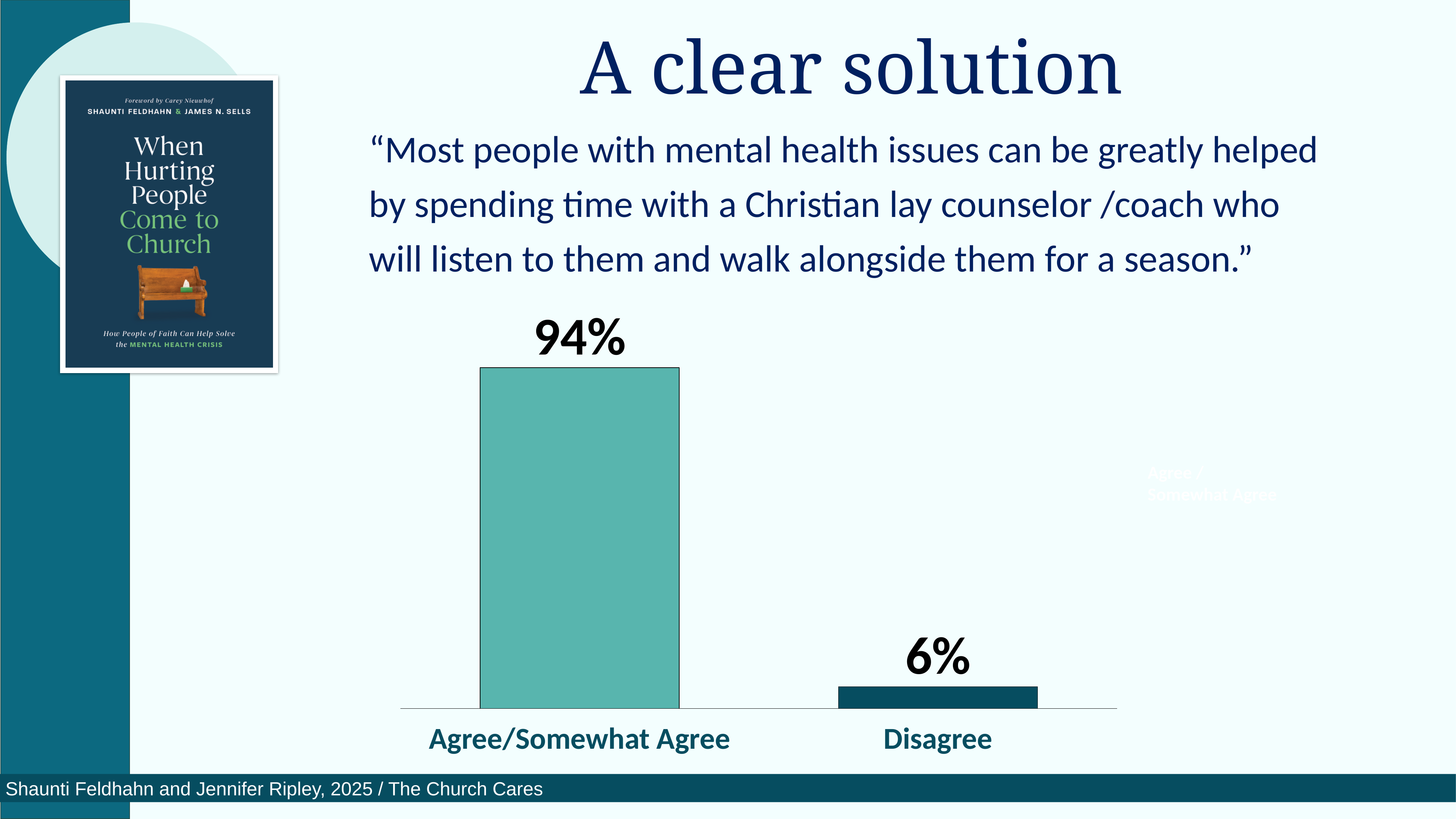
Which category has the highest value? Agree/Somewhat Agree What percentage of respondents chose Disagree? 6% Which bar is drawn in the darker teal colour? Disagree How many categories are shown in the chart? 2 What kind of chart is shown on the slide? Bar chart What is the title of the slide containing the chart? A clear solution What is the difference between the Agree/Somewhat Agree and Disagree values? 88% Which is larger, the value for Agree/Somewhat Agree or the value for Disagree? Agree/Somewhat Agree Which category has the lowest value? Disagree What is the total of the two values shown in the chart? 100% What percentage of respondents chose Agree/Somewhat Agree? 94%